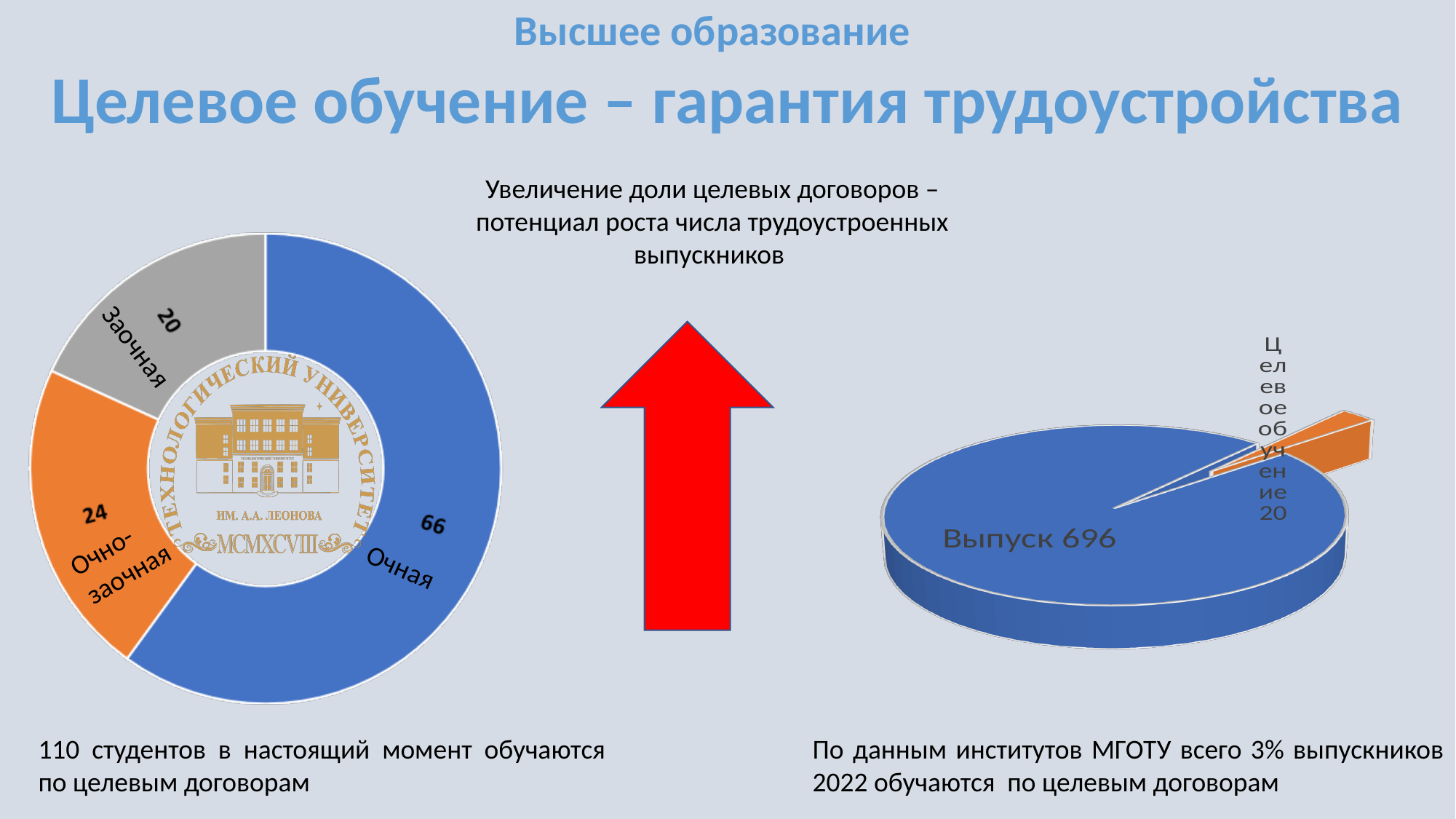
In the left doughnut chart, what is the difference between the values for Очная and Очно-заочная? 42 In the right pie chart, what is the value for Целевое обучение? 20 In the left doughnut chart, which category has the lowest value? Заочная In the left doughnut chart, what is the value for Очно-заочная? 24 In the right pie chart, what is the value for Выпуск? 696 In the left doughnut chart, what share of the total does Очная represent? 60% In the left doughnut chart, which is larger: Очно-заочная or Заочная? Очно-заочная In the left doughnut chart, which category has the highest value? Очная In the left doughnut chart, what is the total of all three segments? 110 In the left doughnut chart, what is the value for Очная? 66 In the left doughnut chart, what is the value for Заочная? 20 How many categories does the left doughnut chart show? 3